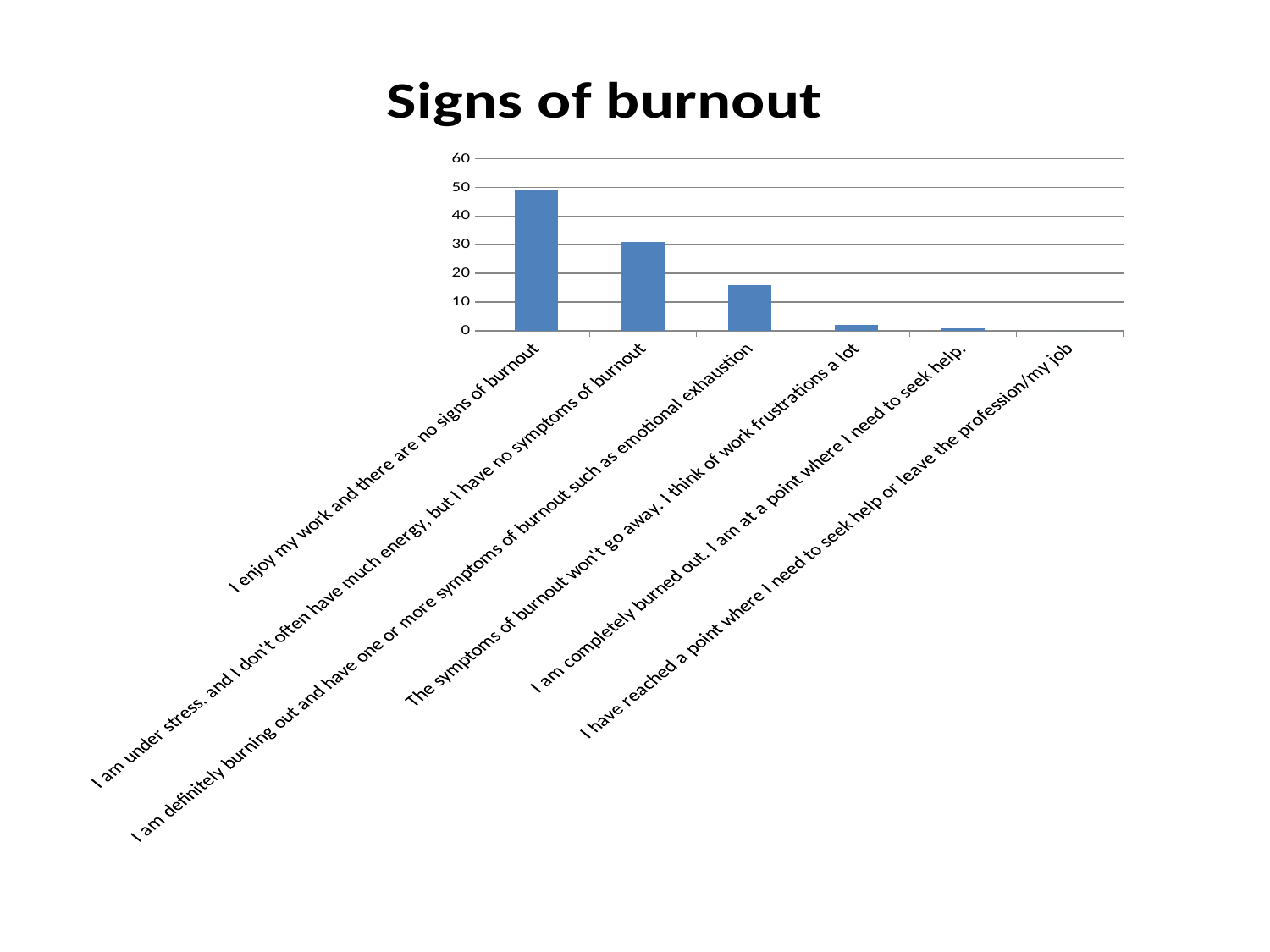
Do the values rise or fall moving from left to right along the x axis? fall Which category has the highest value? I enjoy my work and there are no signs of burnout What is the title of the chart? Signs of burnout Is the value for "The symptoms of burnout won't go away. I think of work frustrations a lot" greater or less than 10? less Is the value for "I am under stress, and I don't often have much energy, but I have no symptoms of burnout" greater or less than 40? less Is the value for "I enjoy my work and there are no signs of burnout" greater or less than 40? greater What kind of chart is shown on the slide? bar chart How many categories are plotted on the x axis? 6 Which is larger: the value for "I enjoy my work and there are no signs of burnout" or the value for "I am under stress, and I don't often have much energy, but I have no symptoms of burnout"? I enjoy my work and there are no signs of burnout Which is larger: the value for "I am definitely burning out and have one or more symptoms of burnout such as emotional exhaustion" or the value for "The symptoms of burnout won't go away. I think of work frustrations a lot"? I am definitely burning out and have one or more symptoms of burnout such as emotional exhaustion